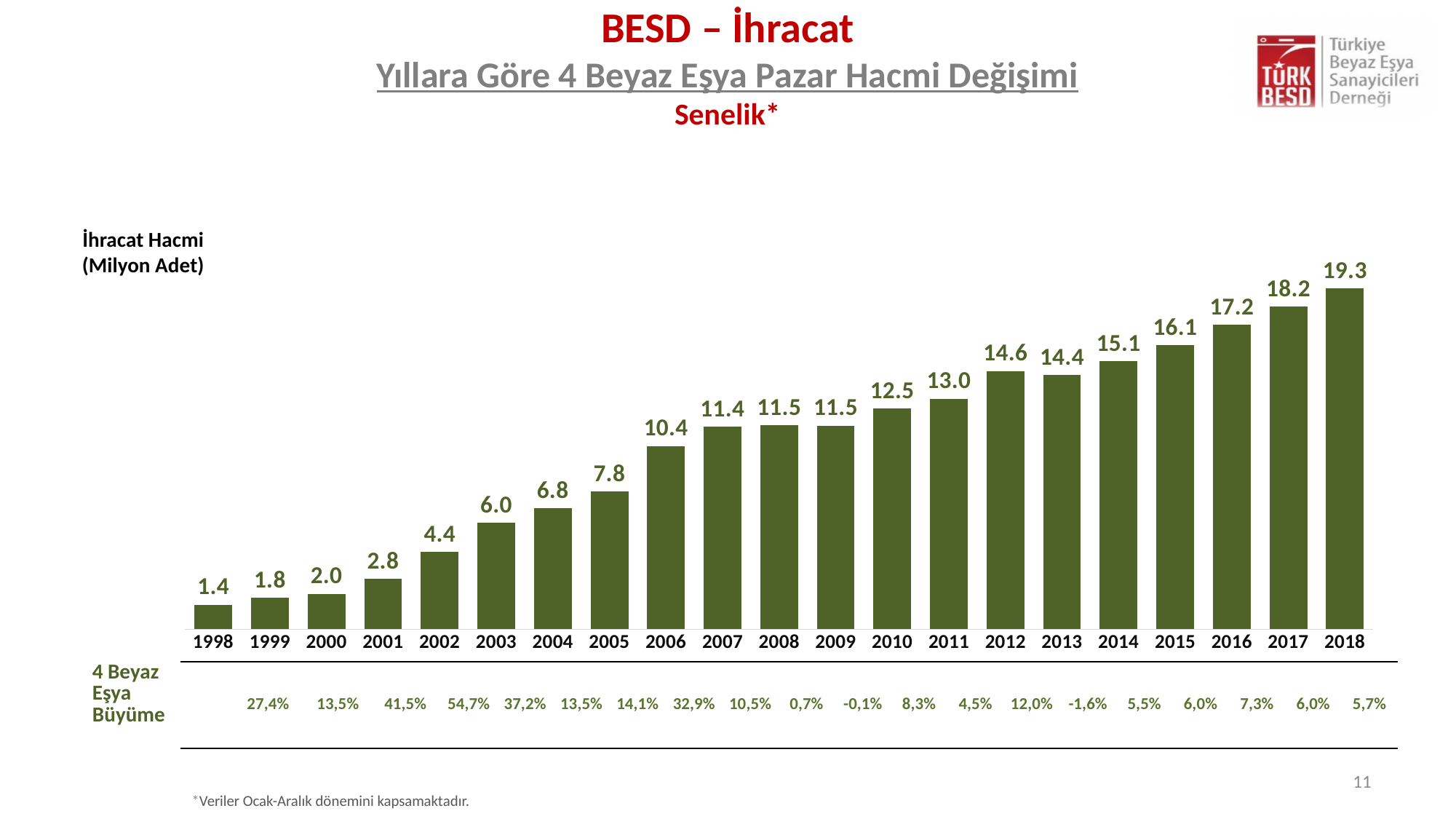
How many years are shown on the x axis of the chart? 21 Which year has the lowest export volume? 1998 What is the difference between the export volume in 2018 and in 2017? 1.1 What kind of chart is used to show the export volume? Bar chart What is the export volume shown for 2006? 10.4 Which year has the highest export volume? 2018 Which year has a larger export volume, 2012 or 2013? 2012 What growth rate (4 Beyaz Eşya Büyüme) is shown for 2013? -1,6% What is the difference between the export volume in 2012 and in 2013? 0.2 What is the export volume (İhracat Hacmi) shown for 2018? 19.3 What is the export volume shown for 1998? 1.4 Do the export volumes generally rise or fall from 1998 to 2018? Rise